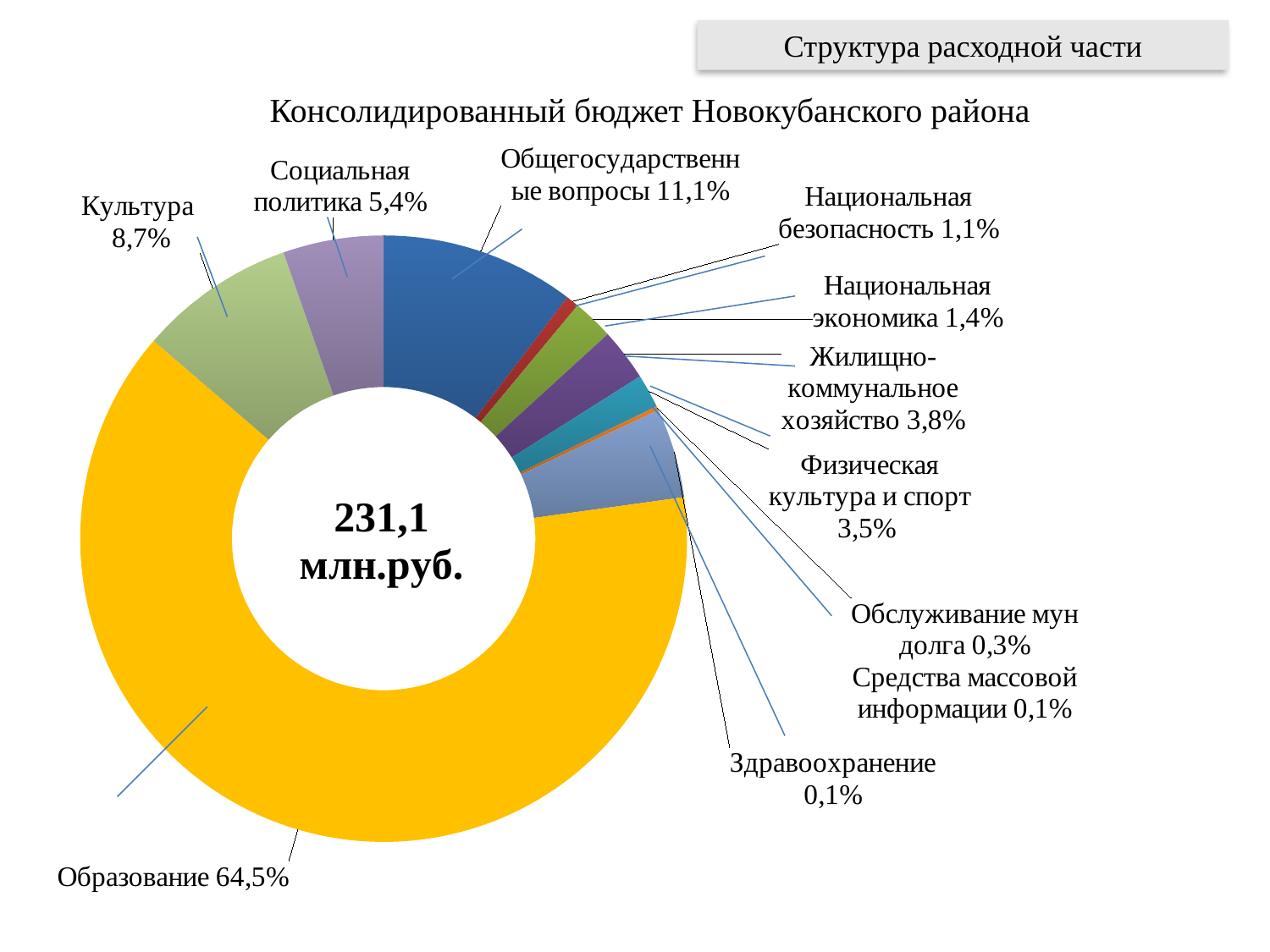
What percentage is labelled for Жилищно-коммунальное хозяйство? 3,8% Which is larger, Национальная экономика or Национальная безопасность? Национальная экономика What is the difference in percentage points between Образование and Общегосударственные вопросы? 53,4 What kind of chart is shown on the slide? Doughnut (pie) chart What is the title of the chart? Консолидированный бюджет Новокубанского района What share of the budget goes to Образование? 64,5% What share is shown for Физическая культура и спорт? 3,5% Which category has the largest share of the chart? Образование What total amount is written in the centre of the chart? 231,1 млн.руб. What share is shown for Общегосударственные вопросы? 11,1% What is the difference in percentage points between Культура and Социальная политика? 3,3